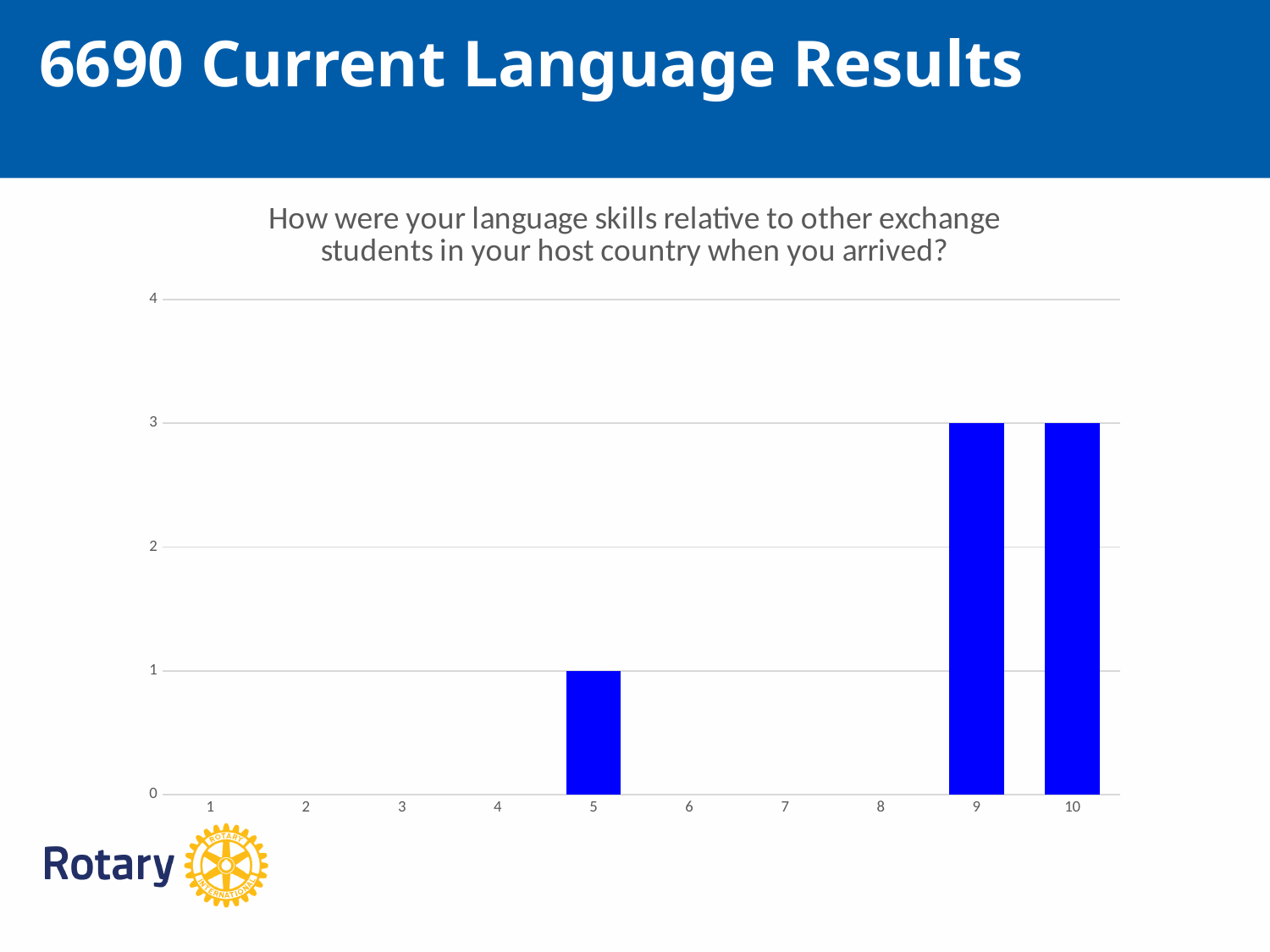
What is the difference between the values for category 9 and category 5? 2 How many categories are shown on the x axis? 10 What is the value for category 9? 3 What type of chart is shown on the slide? bar chart What is the value for category 5? 1 What is the title of the chart? How were your language skills relative to other exchange students in your host country when you arrived? Is the value for category 9 greater or less than 2? greater How many categories have a bar with a non-zero value? 3 Which category has the lowest non-zero value? 5 What is the value for category 10? 3 Which is larger, the value for category 5 or the value for category 10? category 10 What is the value for category 7? 0